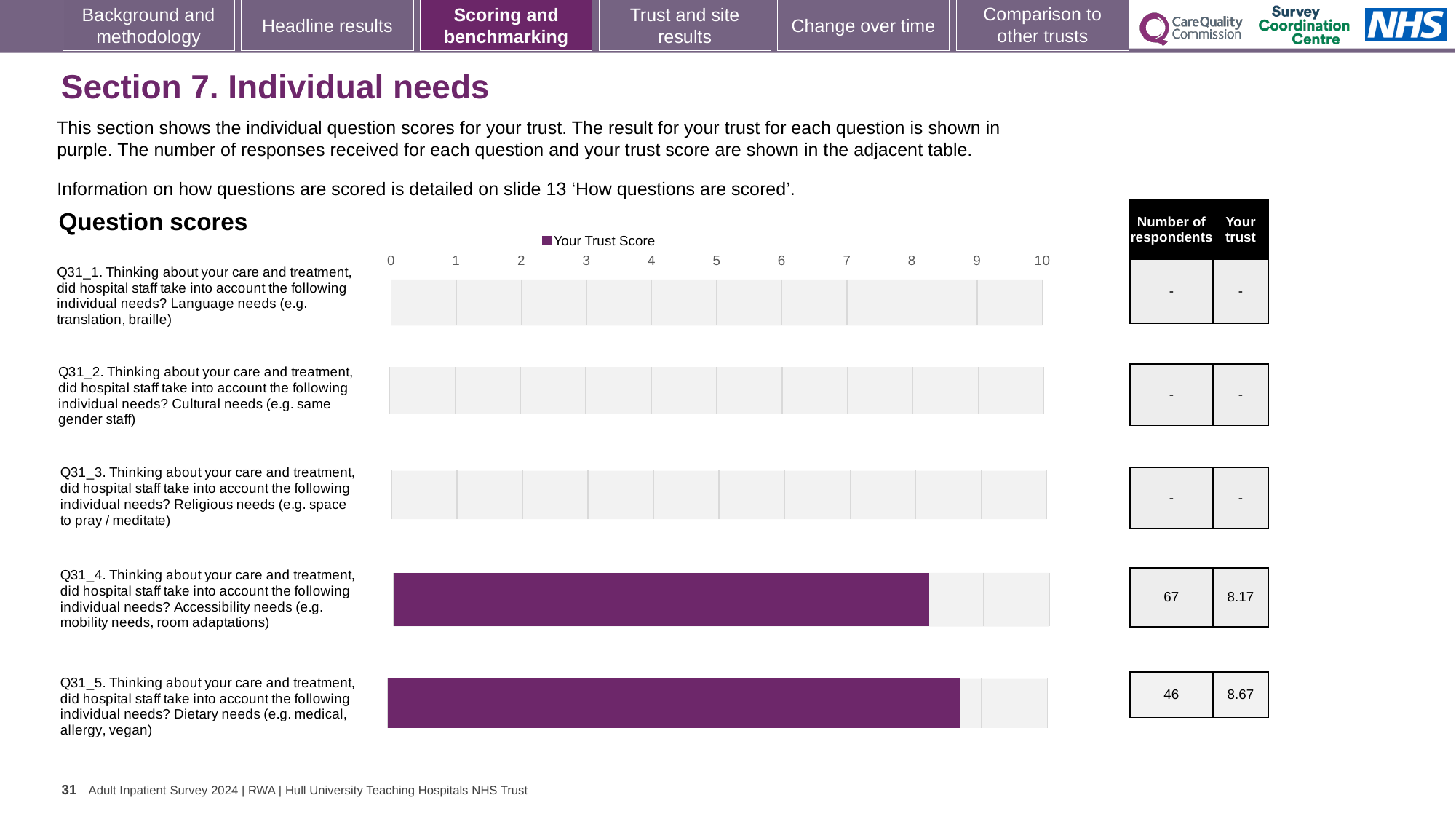
Is the trust score bar for Q31_4 (Accessibility needs) greater or less than 9? less What is the difference between the trust scores for Q31_5 (Dietary needs) and Q31_4 (Accessibility needs)? 0.50 What is the trust score for Q31_5 (Dietary needs)? 8.67 Is the trust score bar for Q31_5 (Dietary needs) greater or less than 8? greater How many respondents answered Q31_4 (Accessibility needs)? 67 What kind of chart is used to show the question scores? bar chart How many respondents answered Q31_5 (Dietary needs)? 46 Which question has the higher trust score, Q31_4 (Accessibility needs) or Q31_5 (Dietary needs)? Q31_5 (Dietary needs) What is the trust score for Q31_4 (Accessibility needs)? 8.17 How many questions are listed in the Question scores section? 5 How many of the Q31 questions on the slide have a plotted trust score bar? 2 What is the single legend entry shown above the question score charts? Your Trust Score